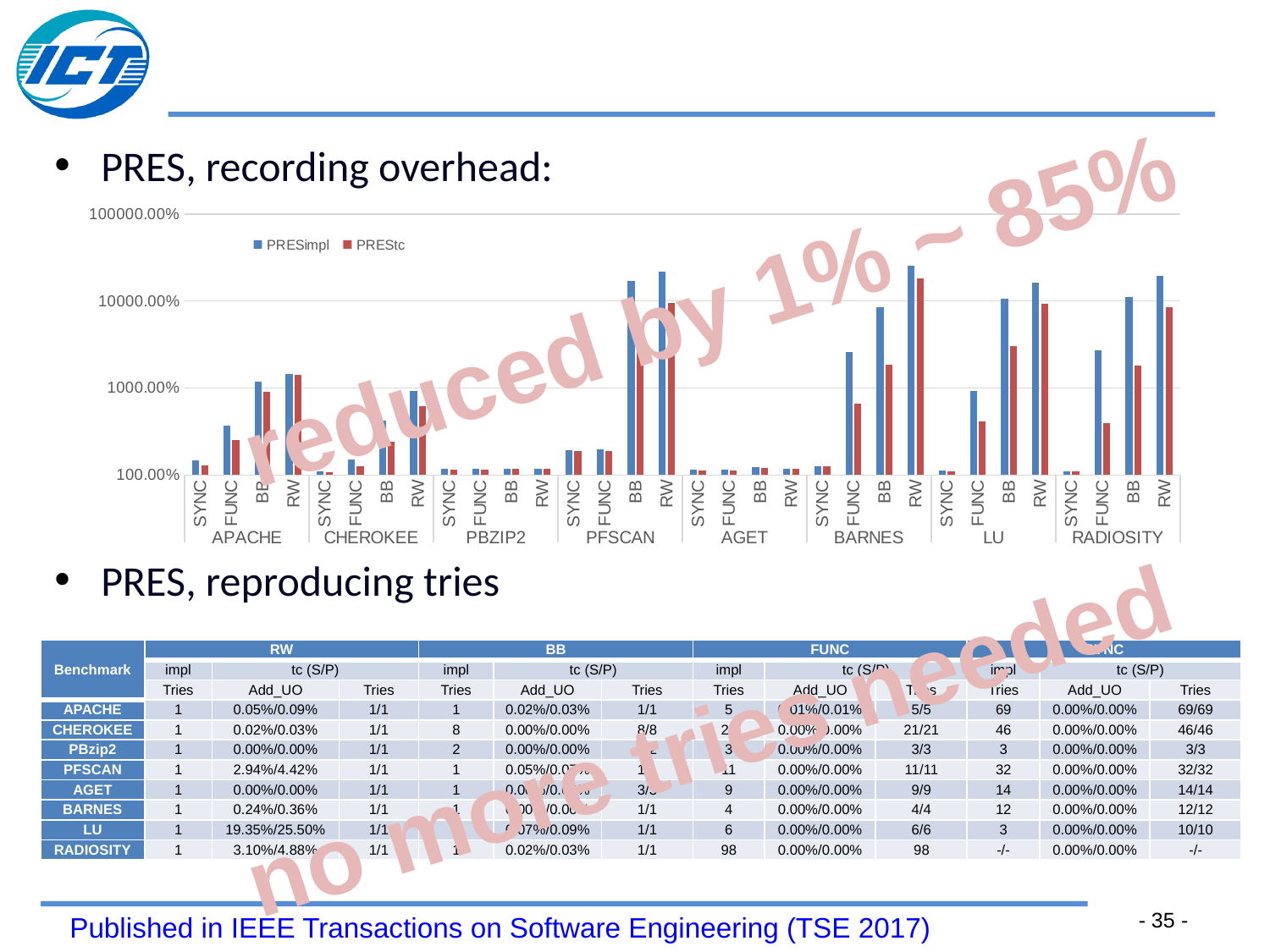
What kind of chart is shown under 'PRES, recording overhead'? bar chart How many benchmark groups are shown along the x axis of the recording overhead chart? 8 In the recording overhead chart, is the PRESimpl value for PBZIP2 BB greater or less than 1000.00%? less In the recording overhead chart, is the PRESimpl value for PFSCAN RW greater or less than 10000.00%? greater How many series does the legend of the recording overhead chart list? 2 In the recording overhead chart, is the PREStc value for BARNES FUNC greater or less than 1000.00%? less In the recording overhead chart, which of the BARNES bars has the highest PRESimpl value: SYNC, FUNC, BB or RW? RW Which colour represents the PREStc series in the recording overhead chart? red In the recording overhead chart, which series has the larger value for PFSCAN RW, PRESimpl or PREStc? PRESimpl What are the two series named in the legend of the recording overhead chart? PRESimpl and PREStc